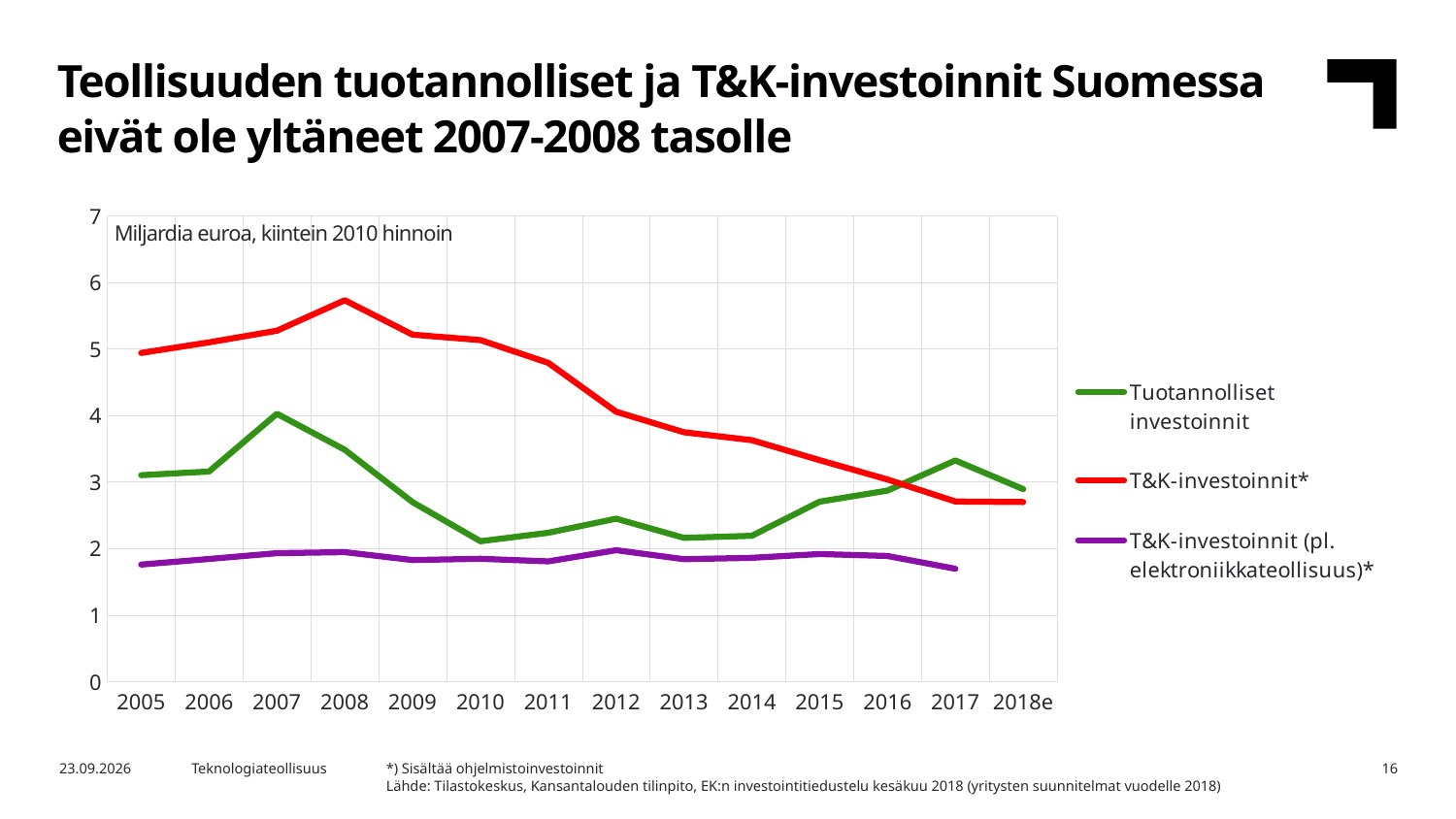
Is the value for T&K-investoinnit* in 2008 greater or less than 5? greater Is the value for Tuotannolliset investoinnit in 2010 greater or less than 3? less In which year does the T&K-investoinnit* series reach its highest value? 2008 Is the value for T&K-investoinnit (pl. elektroniikkateollisuus)* in 2017 greater or less than 2? less In which year does the Tuotannolliset investoinnit series reach its highest value? 2007 In 2017, which is higher: Tuotannolliset investoinnit or T&K-investoinnit*? Tuotannolliset investoinnit In 2005, which is higher: T&K-investoinnit* or Tuotannolliset investoinnit? T&K-investoinnit* Does the T&K-investoinnit* series rise or fall from 2008 to 2017? Fall How many series does the legend list? 3 What unit label is shown inside the chart area? Miljardia euroa, kiintein 2010 hinnoin What type of chart is shown on the slide? Line chart How many years are shown on the x axis? 14